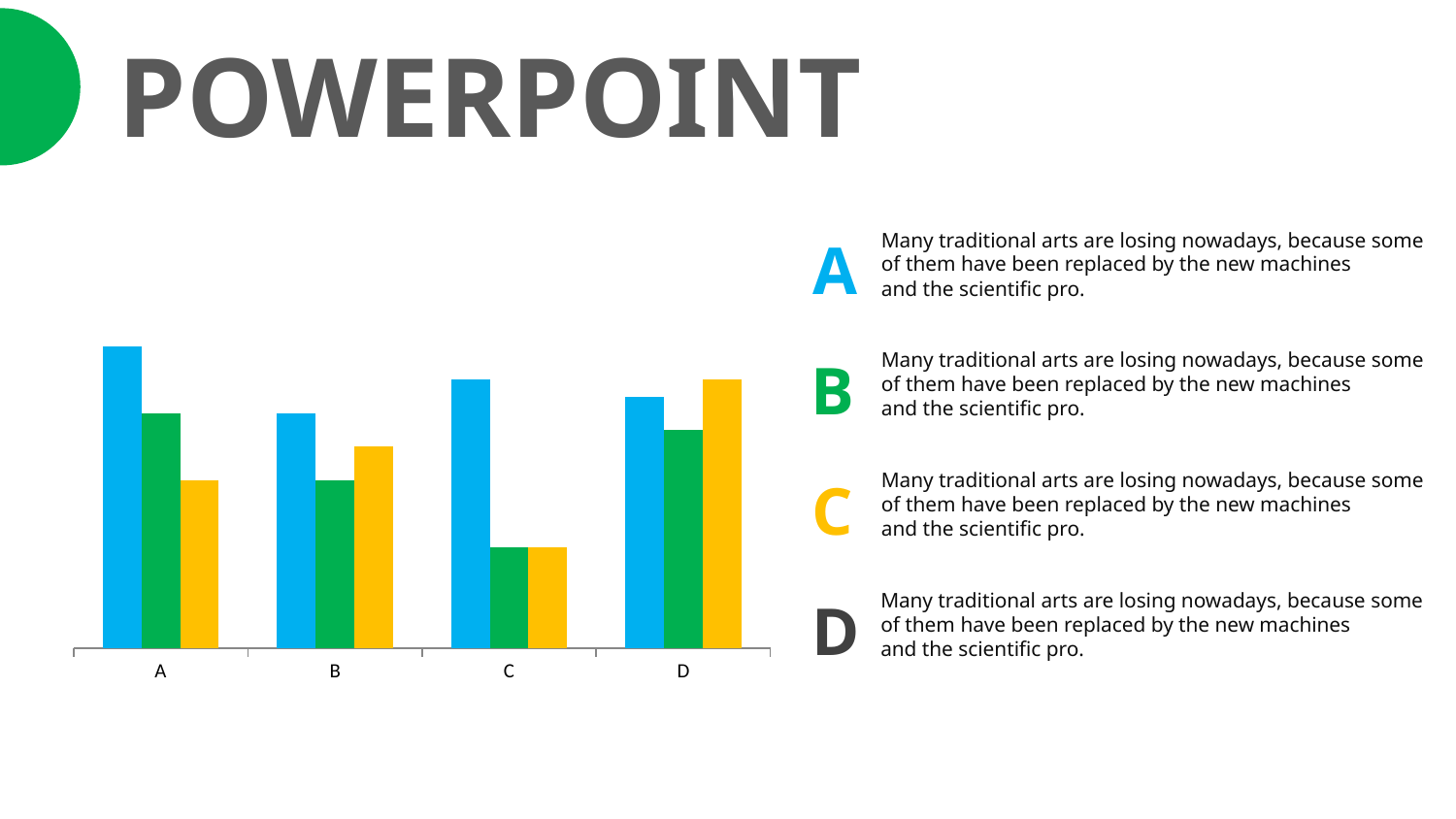
What kind of chart is shown on the slide? Bar chart In category A, which is taller: the blue bar or the yellow bar? Blue How many categories are shown on the x axis of the chart? 4 What are the category labels on the x axis of the chart? A, B, C, D Which is taller: the yellow bar in category A or the yellow bar in category D? D Which category has the shortest blue bar? B Which category has the tallest blue bar? A Which category has the tallest yellow bar? D In category B, which is taller: the blue bar or the green bar? Blue How many bars are plotted for each category in the chart? 3 What colours are the three bars in each category of the chart? Blue, green and yellow Which category has the shortest green bar? C